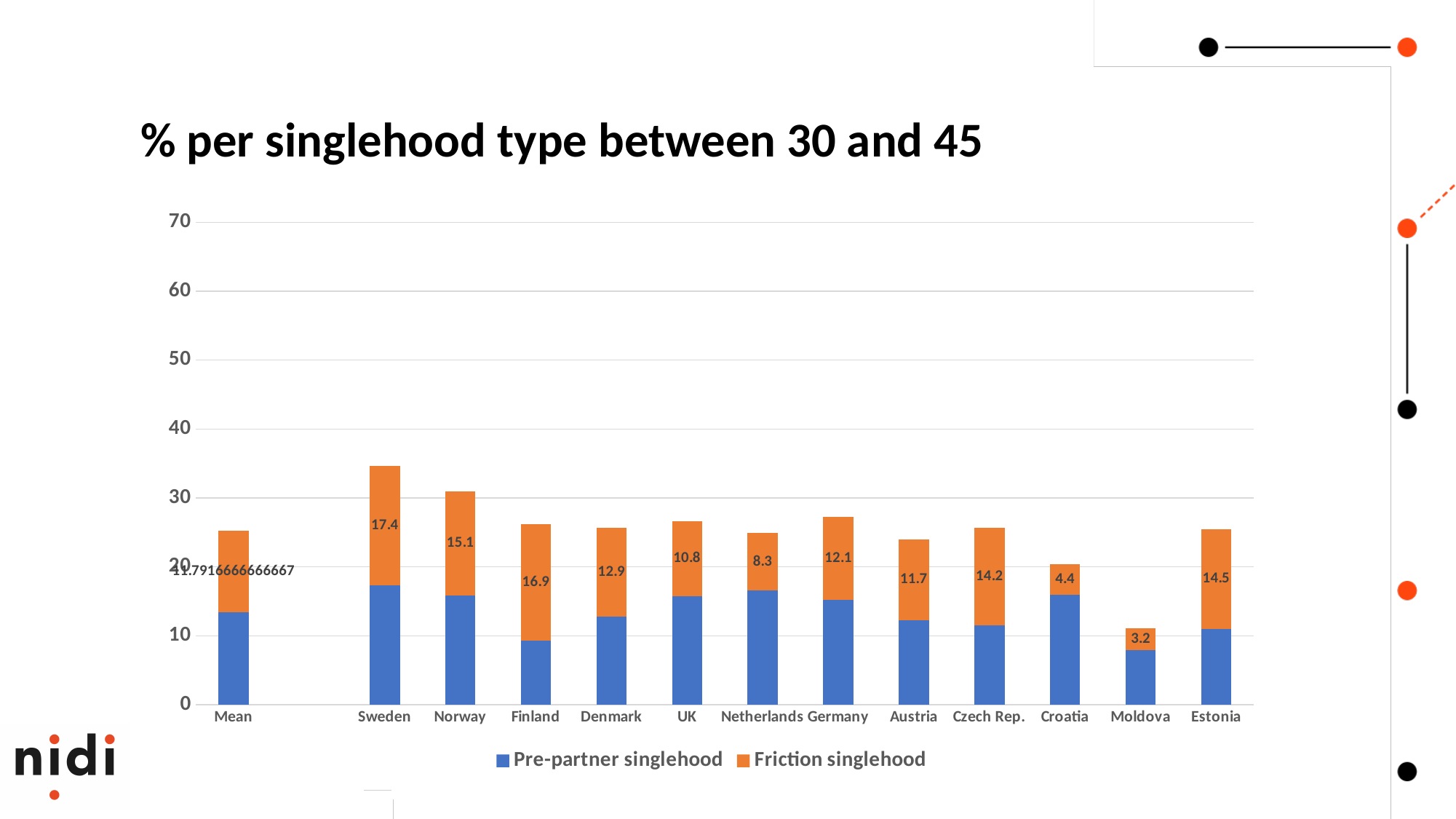
What is the difference between the Friction singlehood values for Finland and Denmark? 4.0 What is the Friction singlehood value for Moldova? 3.2 Which country has the highest Friction singlehood value? Sweden Which has a larger Friction singlehood value, Finland or Norway? Finland How many categories are shown on the x axis? 13 Which country has the lowest Friction singlehood value? Moldova What is the Friction singlehood value for Estonia? 14.5 What kind of chart is shown on the slide? Stacked bar chart What is the Friction singlehood value for Sweden? 17.4 Is the Pre-partner singlehood value for Finland greater or less than 10? less How many series does the legend list? 2 Is the total stacked value for Sweden greater or less than 30? greater